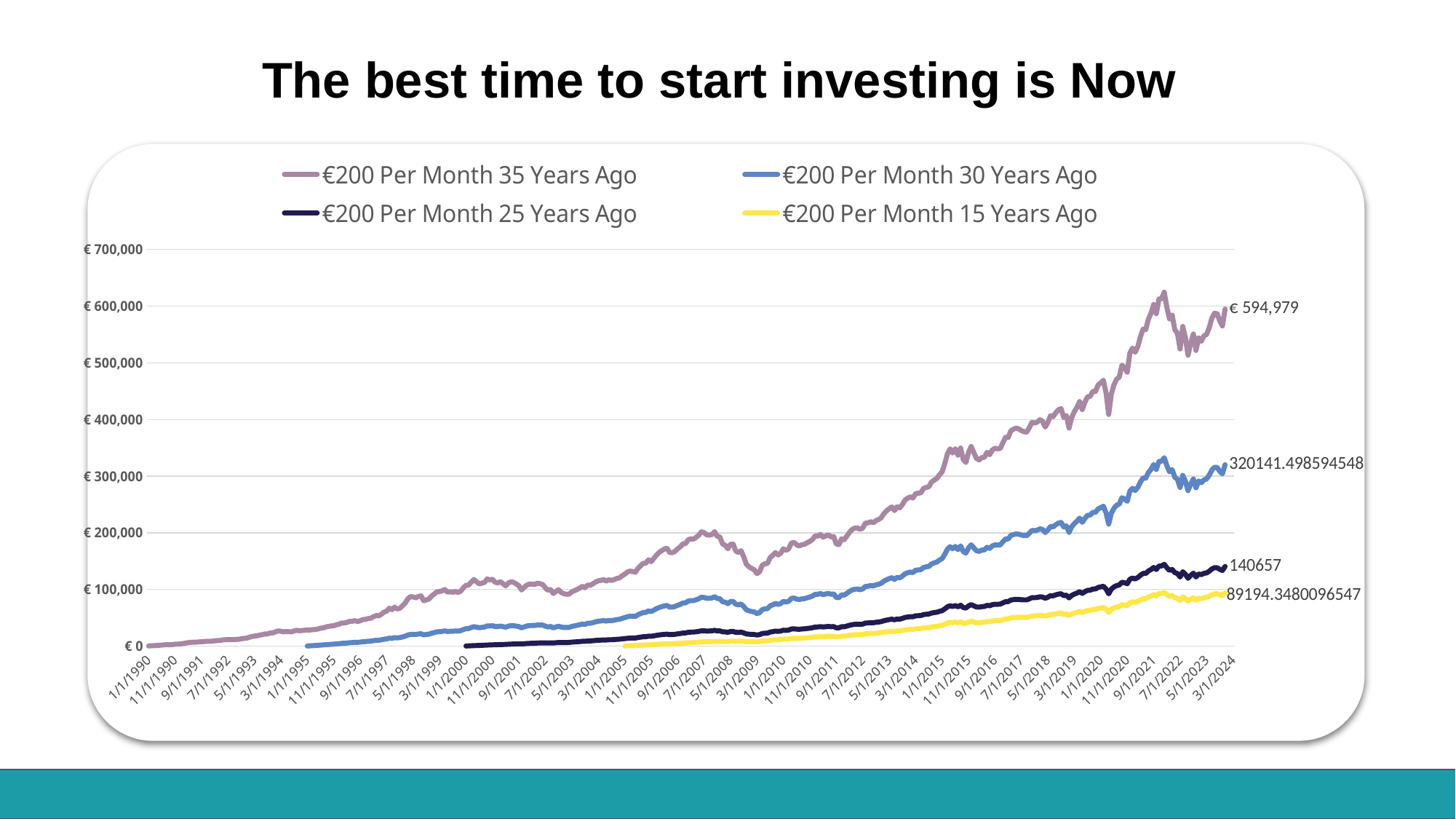
What is the final labelled value of the '€200 Per Month 25 Years Ago' series? 140657 What is the final labelled value of the '€200 Per Month 15 Years Ago' series? 89194.3480096547 How many series does the legend list? 4 Which series ends higher, '€200 Per Month 30 Years Ago' or '€200 Per Month 25 Years Ago'? €200 Per Month 30 Years Ago What is the final labelled value of the '€200 Per Month 35 Years Ago' series? € 594,979 Which series ends with the highest value? €200 Per Month 35 Years Ago What kind of chart is shown on the slide? line chart Overall, do the values of the '€200 Per Month 35 Years Ago' series rise or fall from 1990 to 2024? rise Which series ends with the lowest value? €200 Per Month 15 Years Ago Is the peak value of the '€200 Per Month 35 Years Ago' series greater or less than € 600,000? greater What is the final labelled value of the '€200 Per Month 30 Years Ago' series? 320141.498594548 What is the title of the slide containing the chart? The best time to start investing is Now